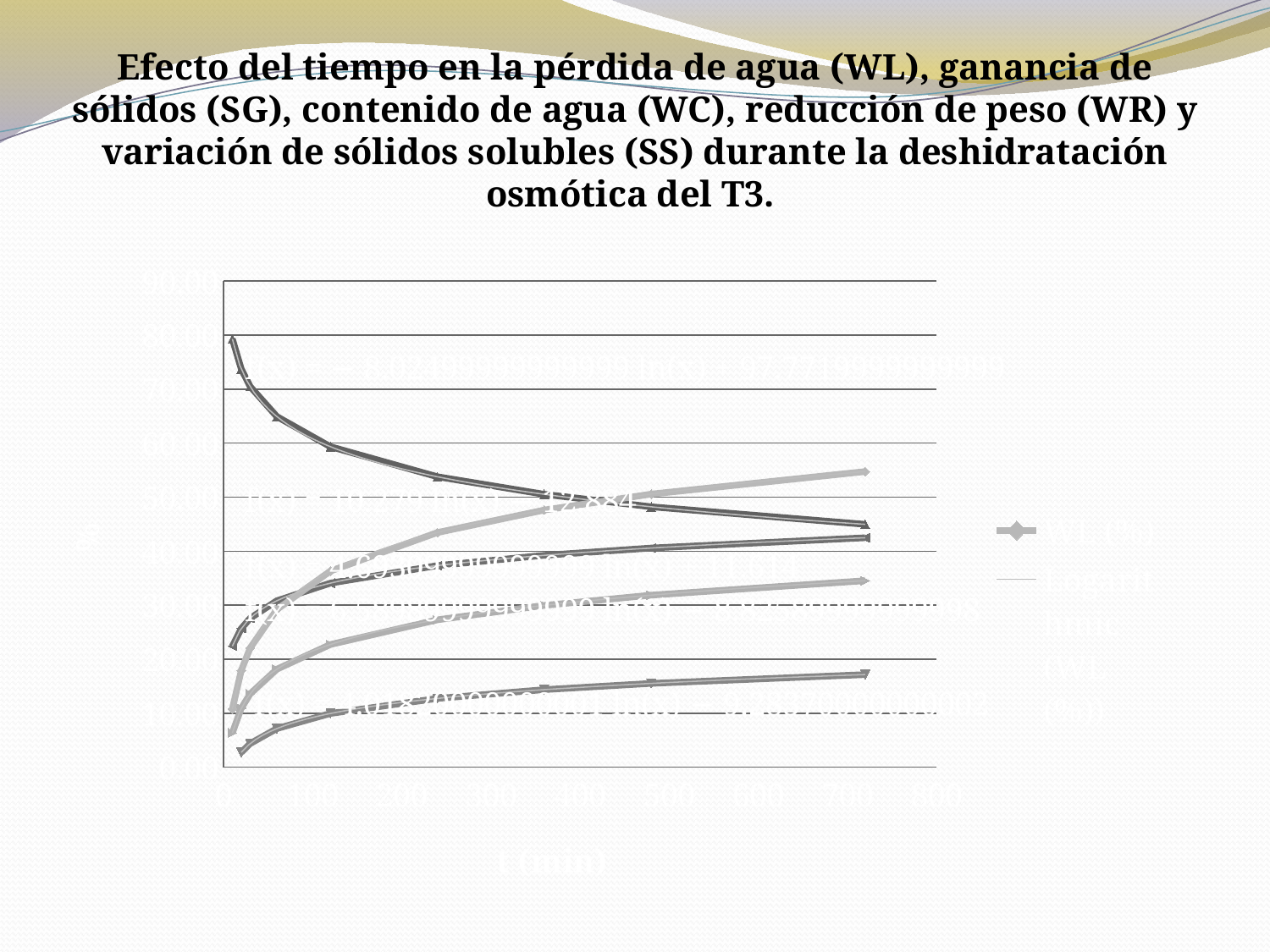
What is the first entry listed in the chart legend? WL (%) Is the first point of the series that starts highest (near t = 20) greater or less than 70? greater What is the title of the x axis of the chart? t (min) Does the series that ends highest on the right side of the chart (around t = 700) rise or fall as t (min) increases? rise What kind of chart is shown on the slide? line chart Does the series that starts highest (near 80 at the left) rise or fall as t (min) increases? fall Is the last point of the series that ends highest on the right (around t = 700) greater or less than 50? greater Is the value of the lowest series at its last point (around t = 700) greater or less than 20? less